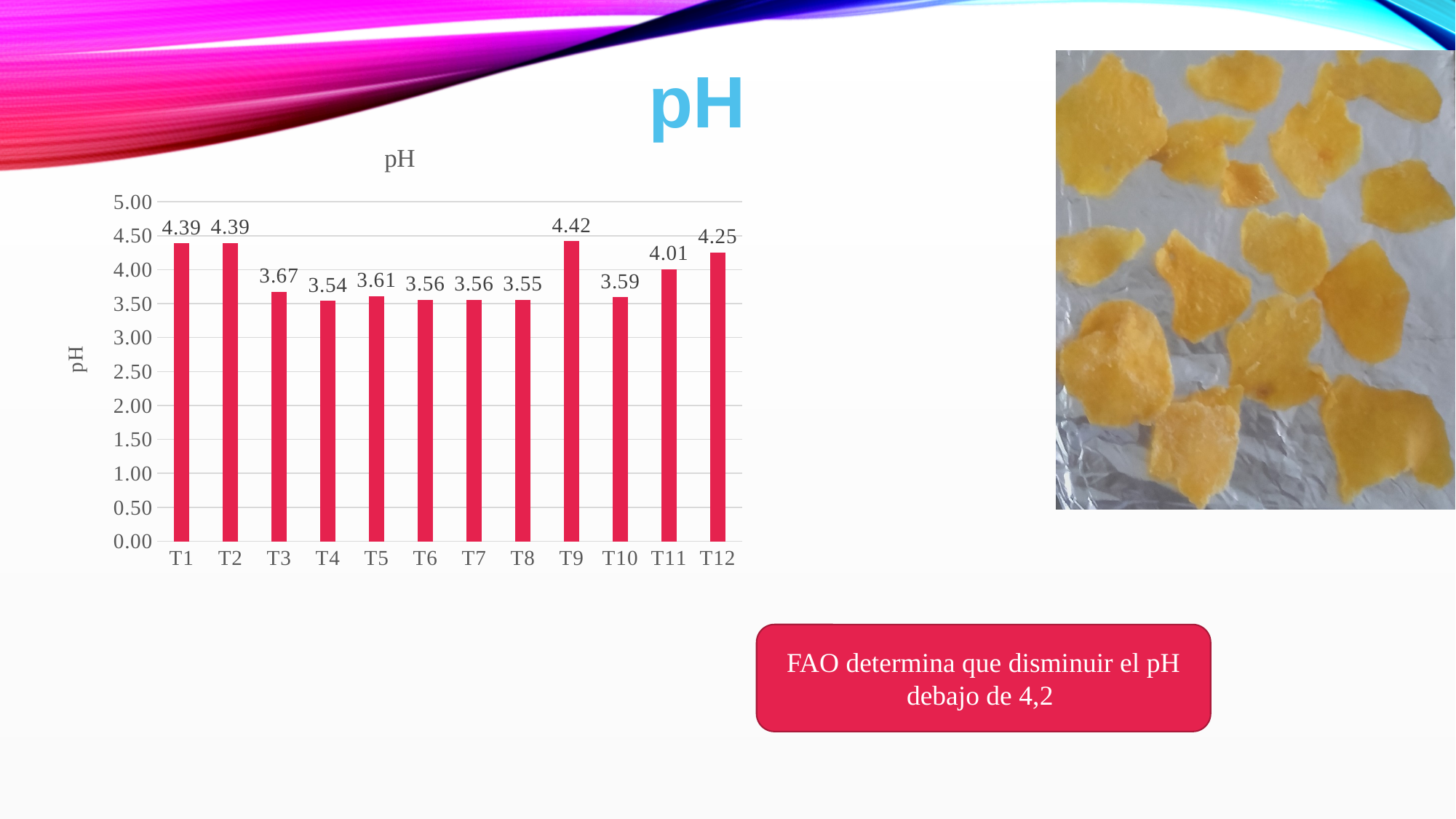
What is the pH value for T11? 4.01 Which has a higher pH, T3 or T10? T3 What is the difference in pH between T12 and T11? 0.24 Which treatment has the highest pH? T9 Is the pH value for T12 greater or less than 4.00? greater What is the difference in pH between T9 and T4? 0.88 What is the title of the chart? pH How many treatments are shown on the x axis? 12 What kind of chart is shown on the slide? Bar chart Which treatment has the lowest pH? T4 What is the pH value for T9? 4.42 What is the pH value for T4? 3.54